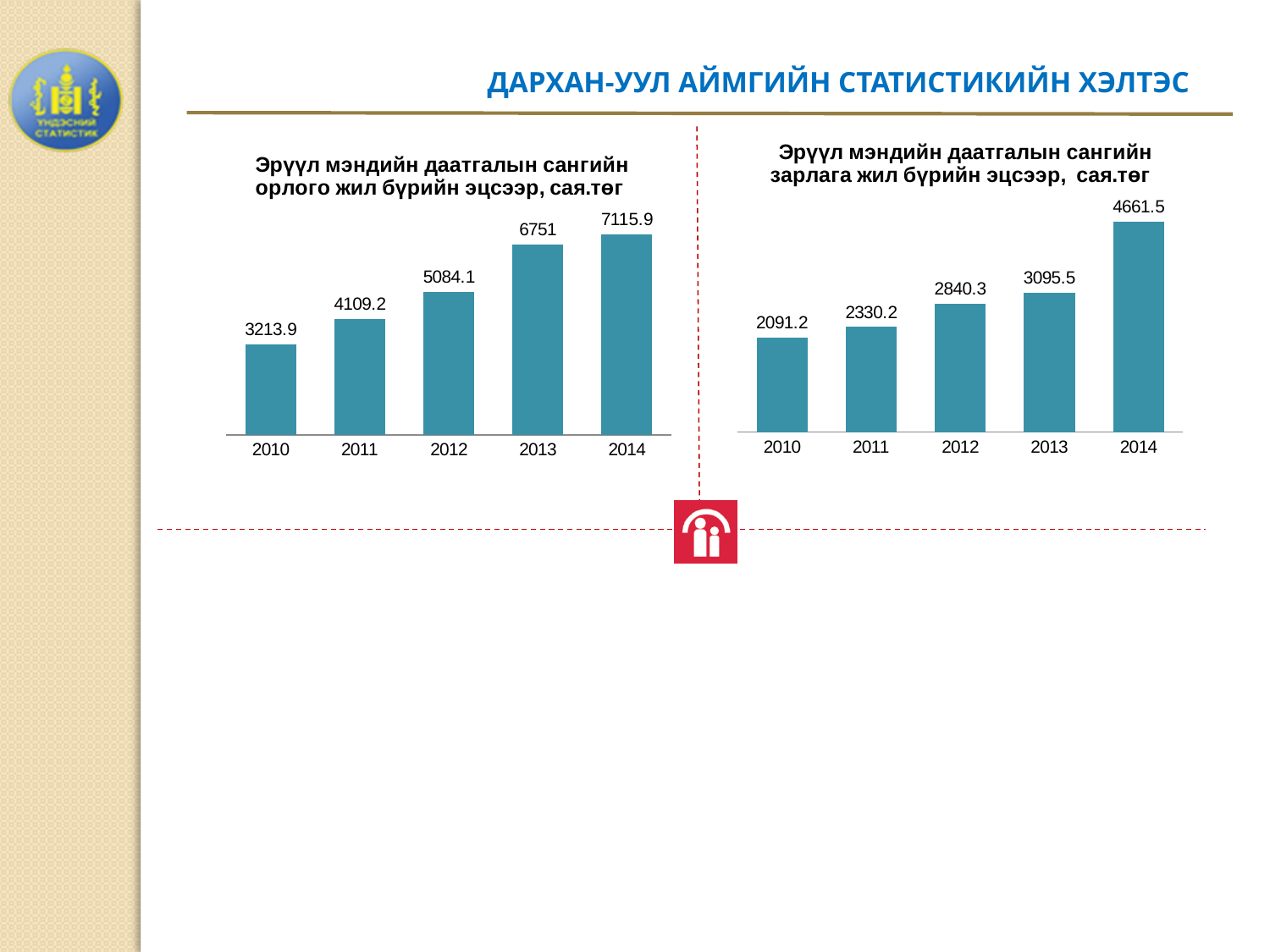
Which is larger: the 2011 value in the left chart or the 2011 value in the right chart? The left chart (4109.2) In the right chart, which year has the lowest value? 2010 How many years are shown on the x axis of the right chart? 5 In the left chart (Эрүүл мэндийн даатгалын сангийн орлого), what is the value for 2012? 5084.1 In the right chart, what is the difference between the 2014 and 2013 values? 1566 In the left chart, what is the difference between the 2014 and 2013 values? 364.9 In the right chart (Эрүүл мэндийн даатгалын сангийн зарлага), what is the value for 2013? 3095.5 In the left chart, which year has the highest value? 2014 In the right chart, do the values rise or fall from 2010 to 2014? Rise In the left chart, what is the value for 2010? 3213.9 What unit is given in the title of the right chart? сая.төг What type of chart is the left chart? Bar chart